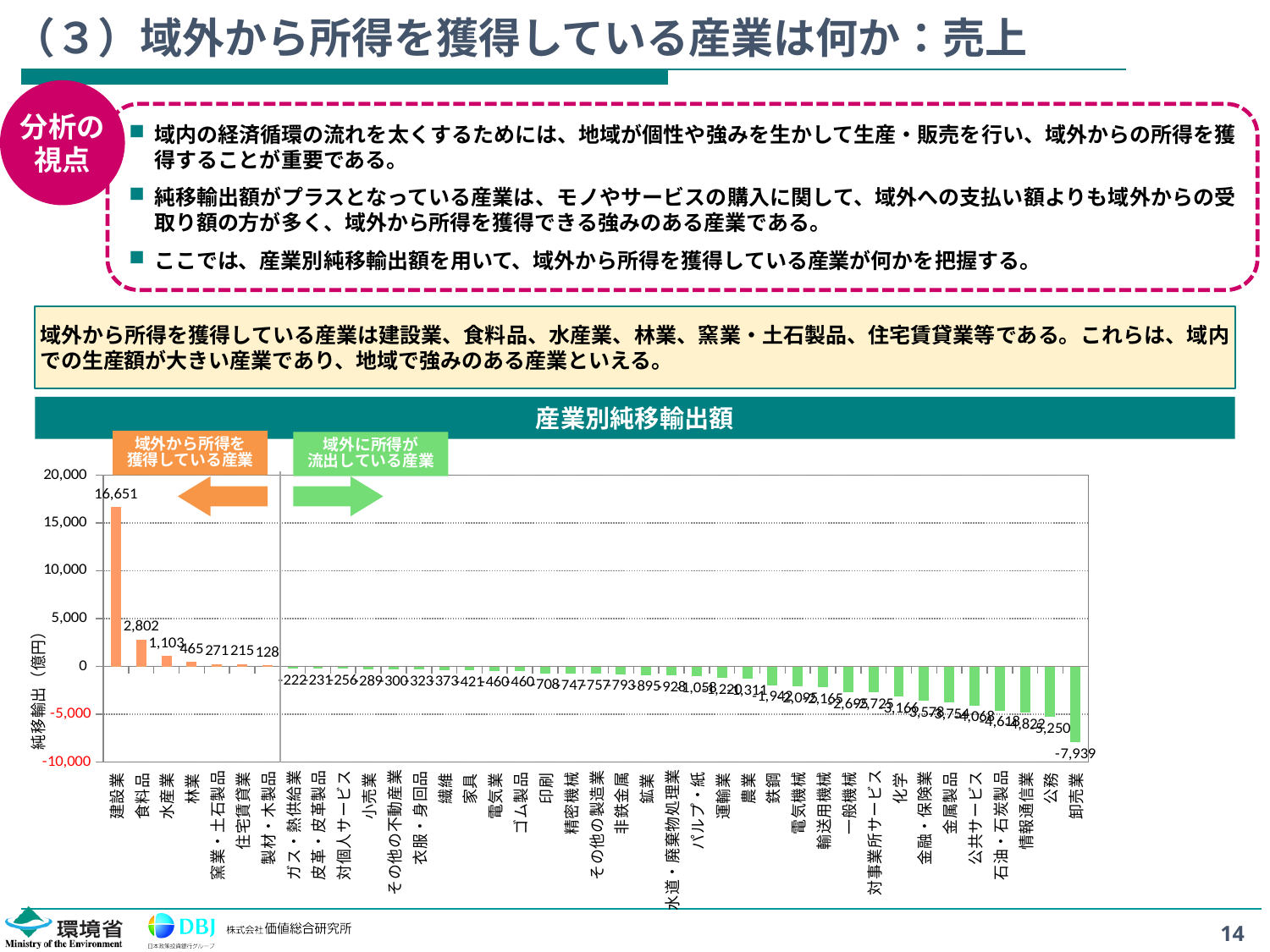
Which industry has the highest value in the 産業別純移輸出額 chart? 建設業 What kind of chart is the 産業別純移輸出額 chart? bar chart In the 産業別純移輸出額 chart, do the values rise or fall from left to right along the x axis? fall In the 産業別純移輸出額 chart, which is larger, the value for 水産業 or the value for 林業? 水産業 In the 産業別純移輸出額 chart, what is the value for 製材・木製品? 128 In the 産業別純移輸出額 chart, is the value for 卸売業 greater or less than -5,000? less How many industries have a positive value in the 産業別純移輸出額 chart? 7 In the 産業別純移輸出額 chart, what is the value for 卸売業? -7,939 In the 産業別純移輸出額 chart, what is the value for 建設業? 16,651 In the 産業別純移輸出額 chart, what is the value for 食料品? 2,802 In the 産業別純移輸出額 chart, what is the difference between the values for 建設業 and 食料品? 13,849 Which industry has the lowest value in the 産業別純移輸出額 chart? 卸売業